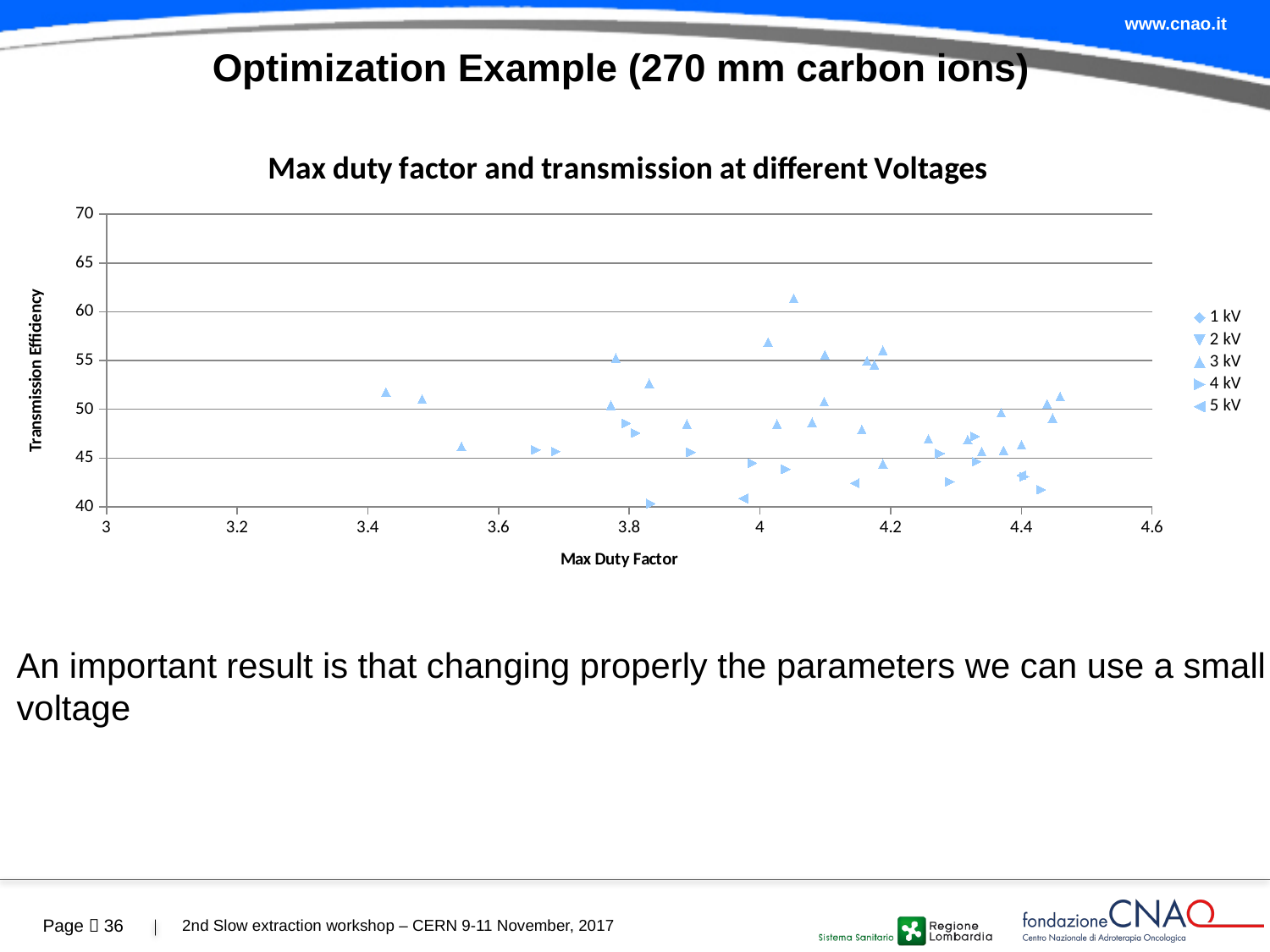
What kind of chart is shown on the slide? scatter chart What is the title of the chart? Max duty factor and transmission at different Voltages How many series does the legend list? 5 Is the lowest transmission efficiency plotted on the chart greater or less than 45? less Is the highest transmission efficiency plotted on the chart greater or less than 65? less Is the max duty factor of the rightmost plotted point greater or less than 4.6? less What label is shown on the x axis of the chart? Max Duty Factor